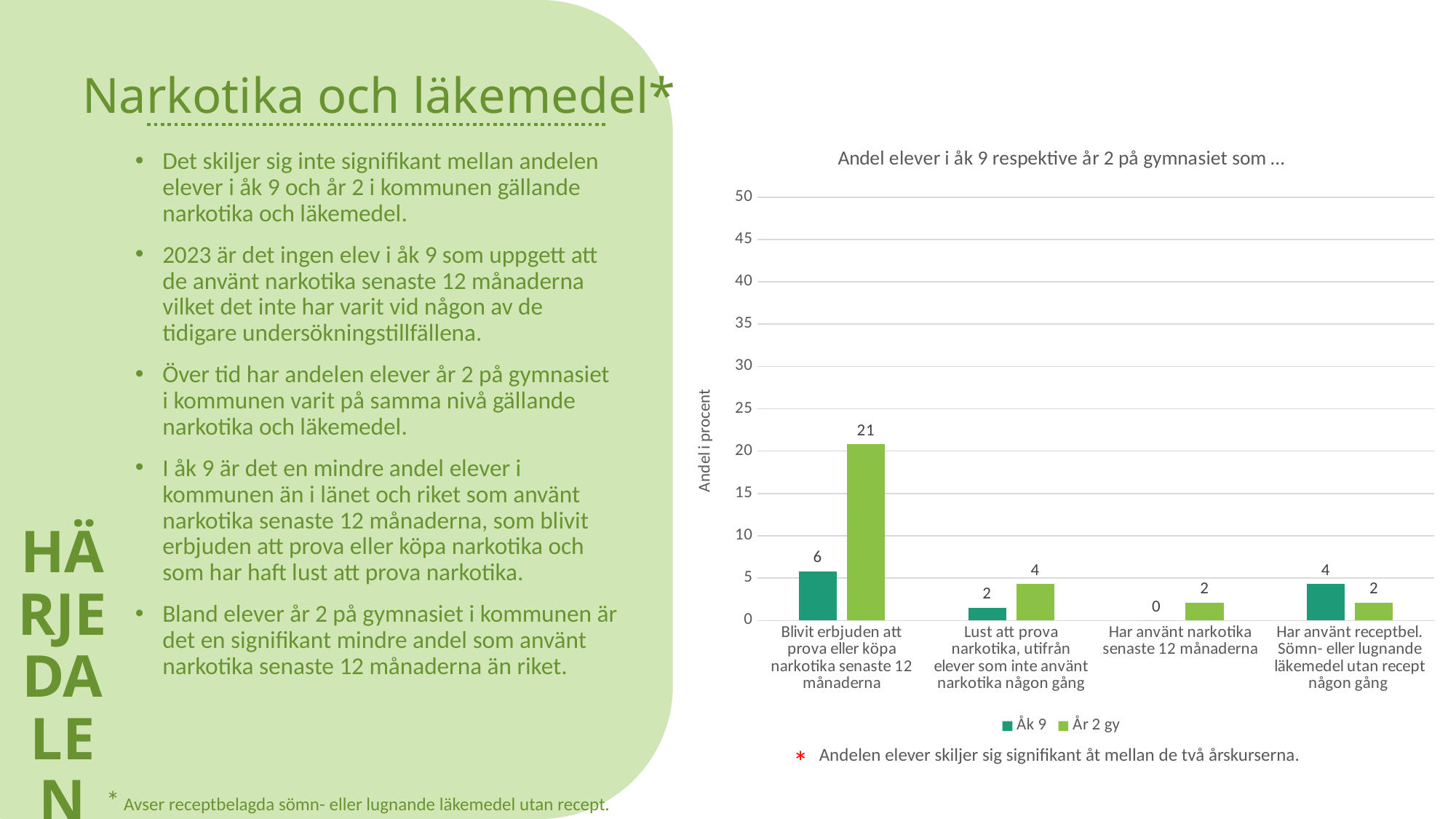
What is the difference between the År 2 gy and Åk 9 values in the category 'Blivit erbjuden att prova eller köpa narkotika senaste 12 månaderna'? 15 How many series does the chart's legend list? 2 Which category has the highest value for År 2 gy? Blivit erbjuden att prova eller köpa narkotika senaste 12 månaderna Which category has the lowest value for Åk 9? Har använt narkotika senaste 12 månaderna In the category 'Har använt receptbel. Sömn- eller lugnande läkemedel utan recept någon gång', which series has the larger value, Åk 9 or År 2 gy? Åk 9 What kind of chart is shown on the slide? Bar chart Is the value for År 2 gy in 'Blivit erbjuden att prova eller köpa narkotika senaste 12 månaderna' greater or less than 20? greater What is the value for Åk 9 in the category 'Blivit erbjuden att prova eller köpa narkotika senaste 12 månaderna'? 6 What is the value for År 2 gy in the category 'Blivit erbjuden att prova eller köpa narkotika senaste 12 månaderna'? 21 How many categories are shown on the x axis of the chart? 4 What is the value for Åk 9 in the category 'Har använt narkotika senaste 12 månaderna'? 0 What is the value for År 2 gy in the category 'Lust att prova narkotika, utifrån elever som inte använt narkotika någon gång'? 4